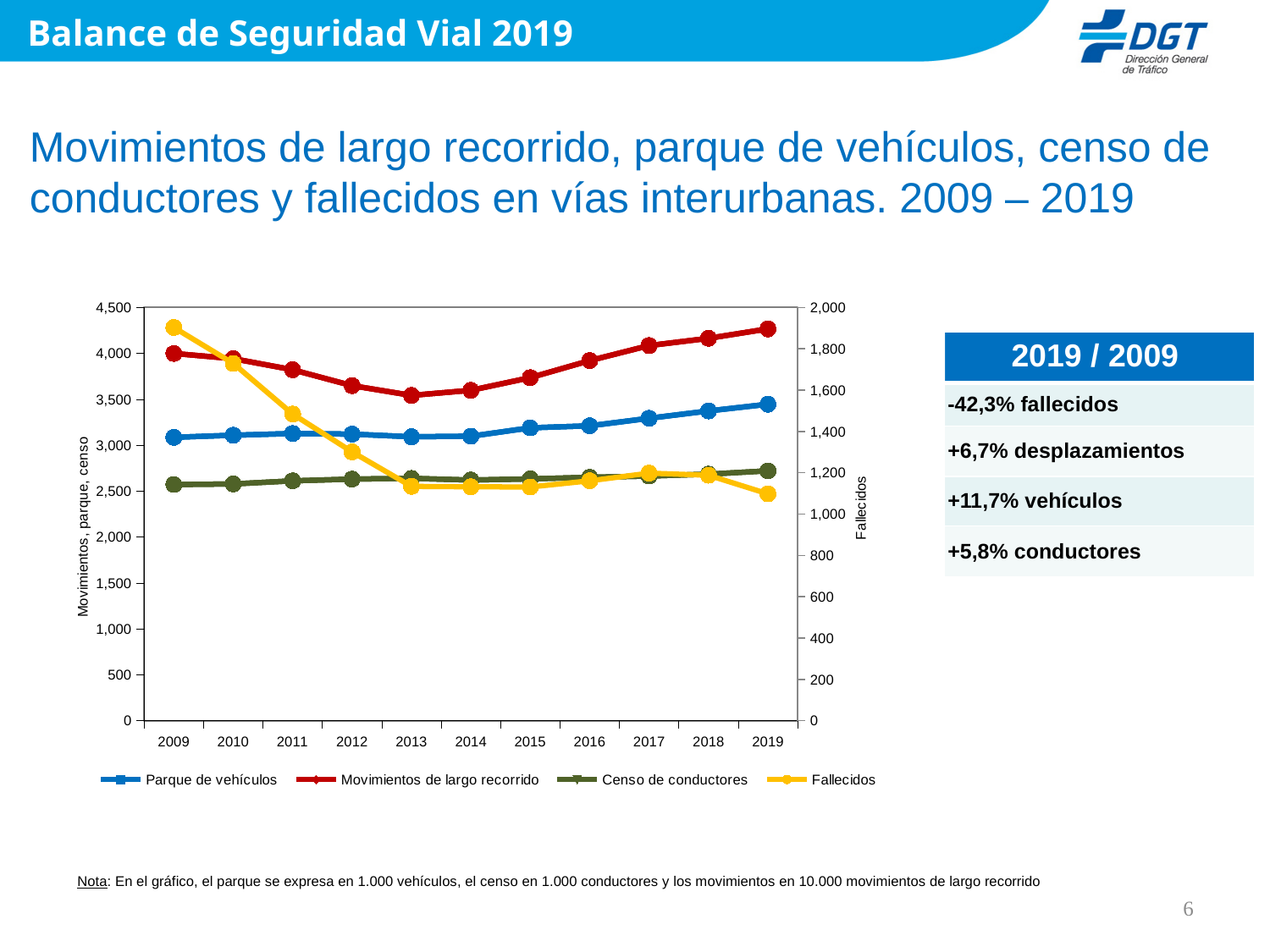
What kind of chart is shown on the slide? Line chart Is the value for Movimientos de largo recorrido in 2019 greater or less than 4,000? greater Does the Fallecidos series rise or fall from 2009 to 2019? Fall Which series in the chart is drawn in yellow? Fallecidos Which series is plotted against the right-hand axis of the chart? Fallecidos In which year is the Movimientos de largo recorrido series at its lowest? 2013 Is the value for Fallecidos in 2019 greater or less than 1,200 on the right axis? less How many series does the chart legend list? 4 In which year is the Fallecidos series at its highest? 2009 In which year is the Movimientos de largo recorrido series at its highest? 2019 How many years are plotted along the x axis of the chart? 11 Is the value for Fallecidos in 2009 greater or less than 1,800 on the right axis? greater